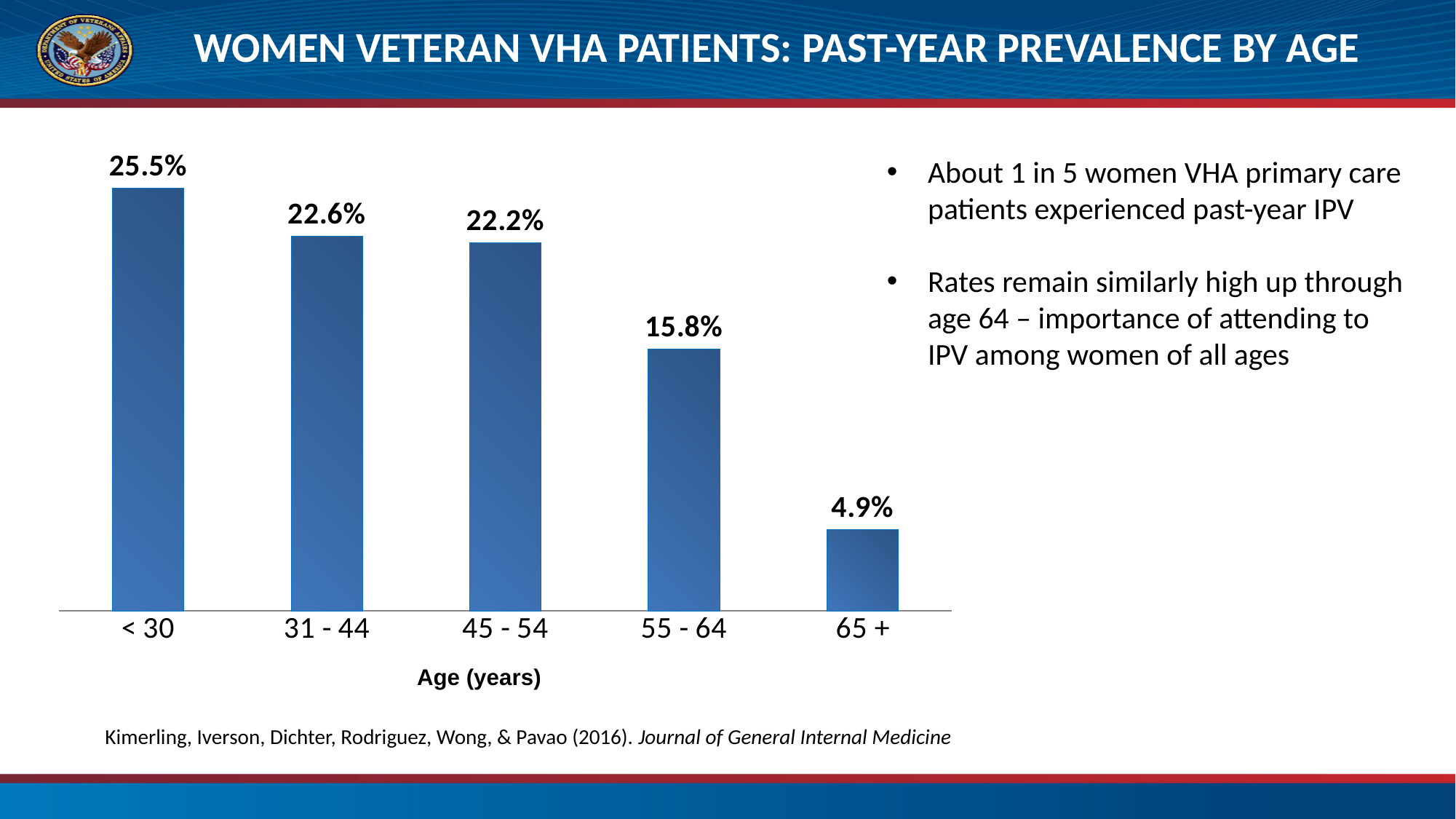
What kind of chart is shown on the slide? Bar chart What is the past-year prevalence for the 65 + age group? 4.9% What is the past-year prevalence for the 55 - 64 age group? 15.8% What is the difference in prevalence between the < 30 and 65 + age groups? 20.6 percentage points Which age group has the lowest past-year prevalence? 65 + Which age group has the highest past-year prevalence? < 30 What is the label of the x axis of the chart? Age (years) What is the difference in prevalence between the 31 - 44 and 45 - 54 age groups? 0.4 percentage points Which age group has a higher prevalence, 45 - 54 or 55 - 64? 45 - 54 What is the past-year prevalence for women veteran VHA patients aged < 30? 25.5% Do the prevalence values rise or fall as age increases along the x axis? Fall How many age groups are shown in the chart? 5